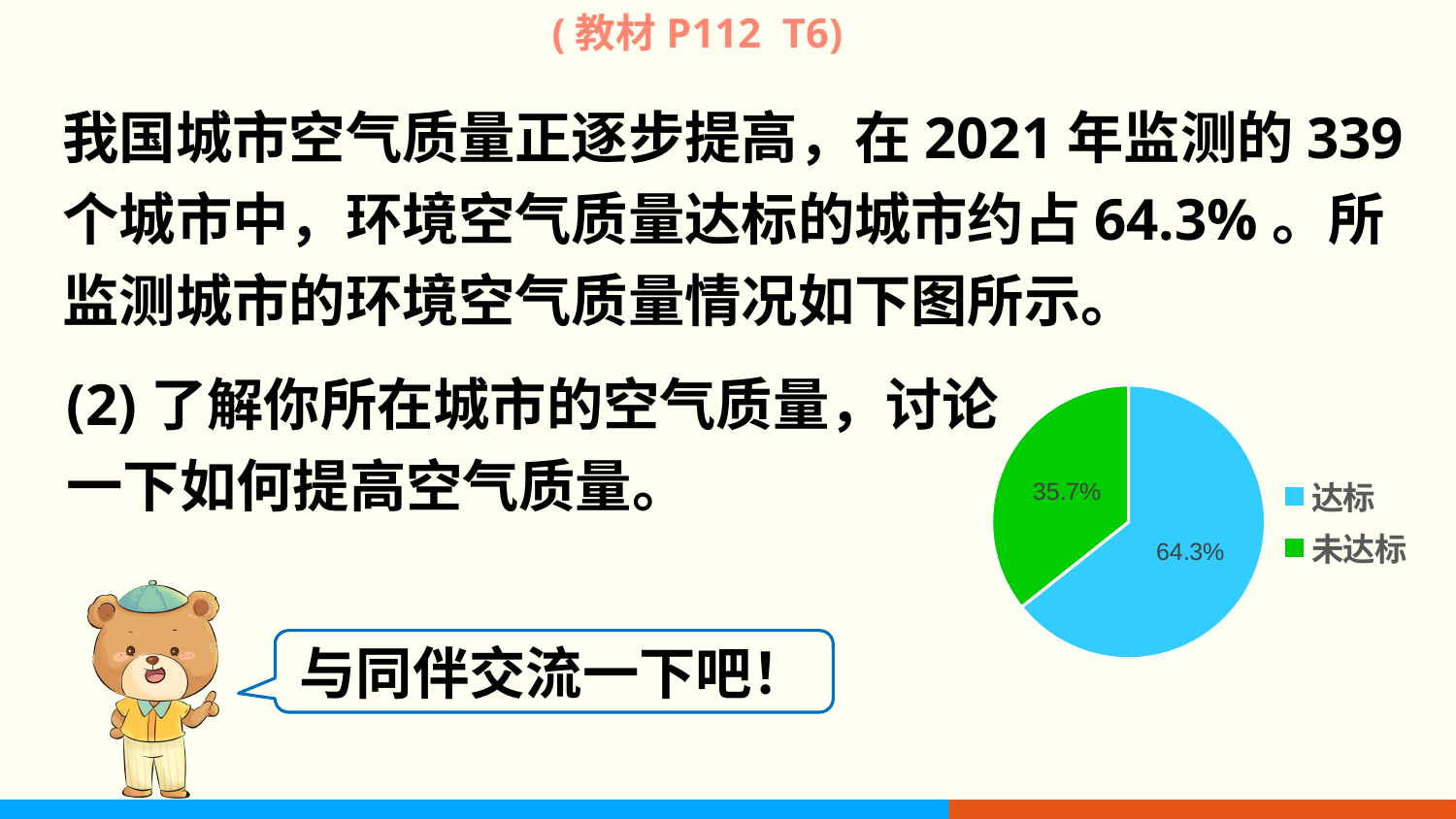
What percentage of the pie chart is labelled 达标? 64.3% What kind of chart is shown on the slide? pie chart Which slice of the pie chart is the smallest? 未达标 What colour is the 未达标 slice in the pie chart? green How many slices does the pie chart have? 2 Which slice of the pie chart is the largest? 达标 What share of the pie does the 未达标 slice take? 35.7% What is the difference between the 达标 and 未达标 shares in the pie chart? 28.6% What colour is the 达标 slice in the pie chart? blue What percentage of the pie chart is labelled 未达标? 35.7% How many entries does the legend of the pie chart list? 2 Which is larger in the pie chart, 达标 or 未达标? 达标